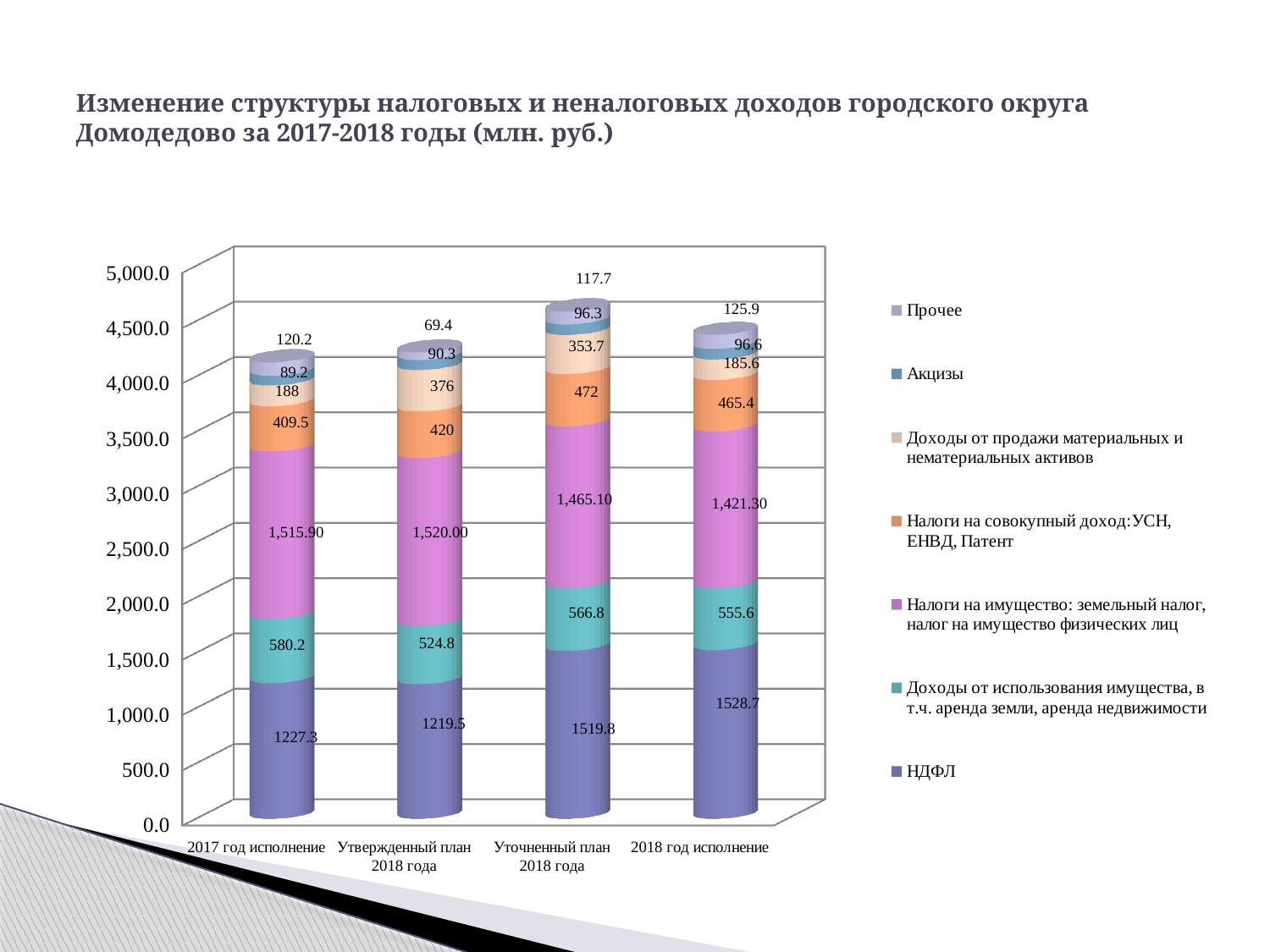
In which category is the value of НДФЛ the highest? 2018 год исполнение What is the total of the stacked bar for 2017 год исполнение? 4130.3 Which series is shown in the bottom segment of each bar? НДФЛ What kind of chart is shown on the slide? Stacked bar chart What is the value of Налоги на имущество for Уточненный план 2018 года? 1,465.10 What is the difference between the НДФЛ values for 2018 год исполнение and 2017 год исполнение? 301.4 How many series does the legend list? 7 What is the value of Акцизы for 2018 год исполнение? 96.6 Which is larger: Доходы от продажи материальных и нематериальных активов for Утвержденный план 2018 года or for 2018 год исполнение? Утвержденный план 2018 года How many categories are shown along the x axis? 4 In which category is the value of Прочее the lowest? Утвержденный план 2018 года What is the value of НДФЛ for 2017 год исполнение? 1227.3